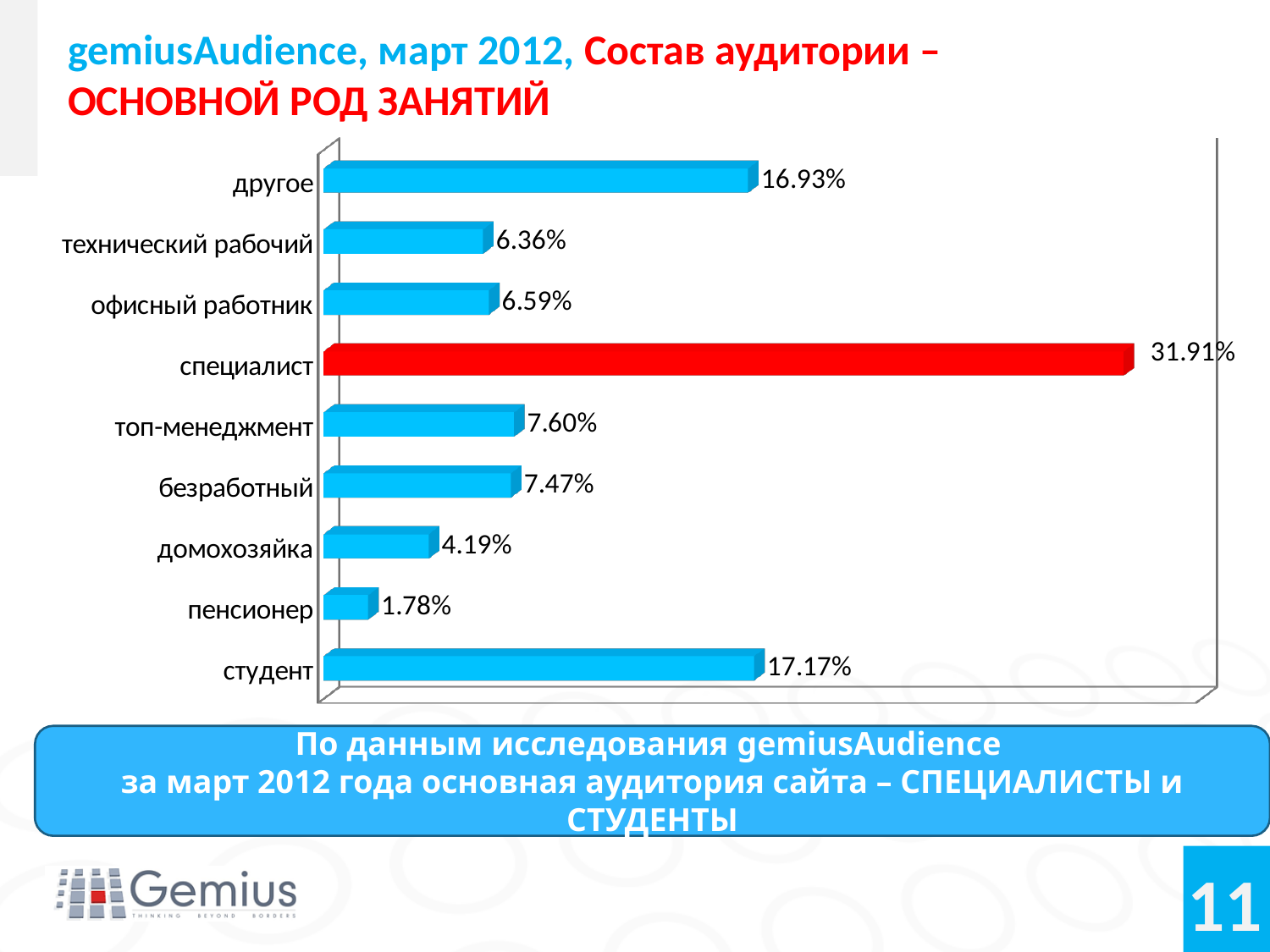
Which bar is coloured red instead of blue? специалист What is the value for домохозяйка? 4.19% Which is larger, the value for офисный работник or the value for технический рабочий? офисный работник How many categories are shown in the chart? 9 What is the value for студент? 17.17% Which category has the highest value? специалист What is the value for пенсионер? 1.78% What kind of chart is shown on the slide? bar chart Which is larger, the value for топ-менеджмент or the value for безработный? топ-менеджмент What is the value for специалист? 31.91% Which category has the lowest value? пенсионер What is the difference between the values for специалист and студент? 14.74%